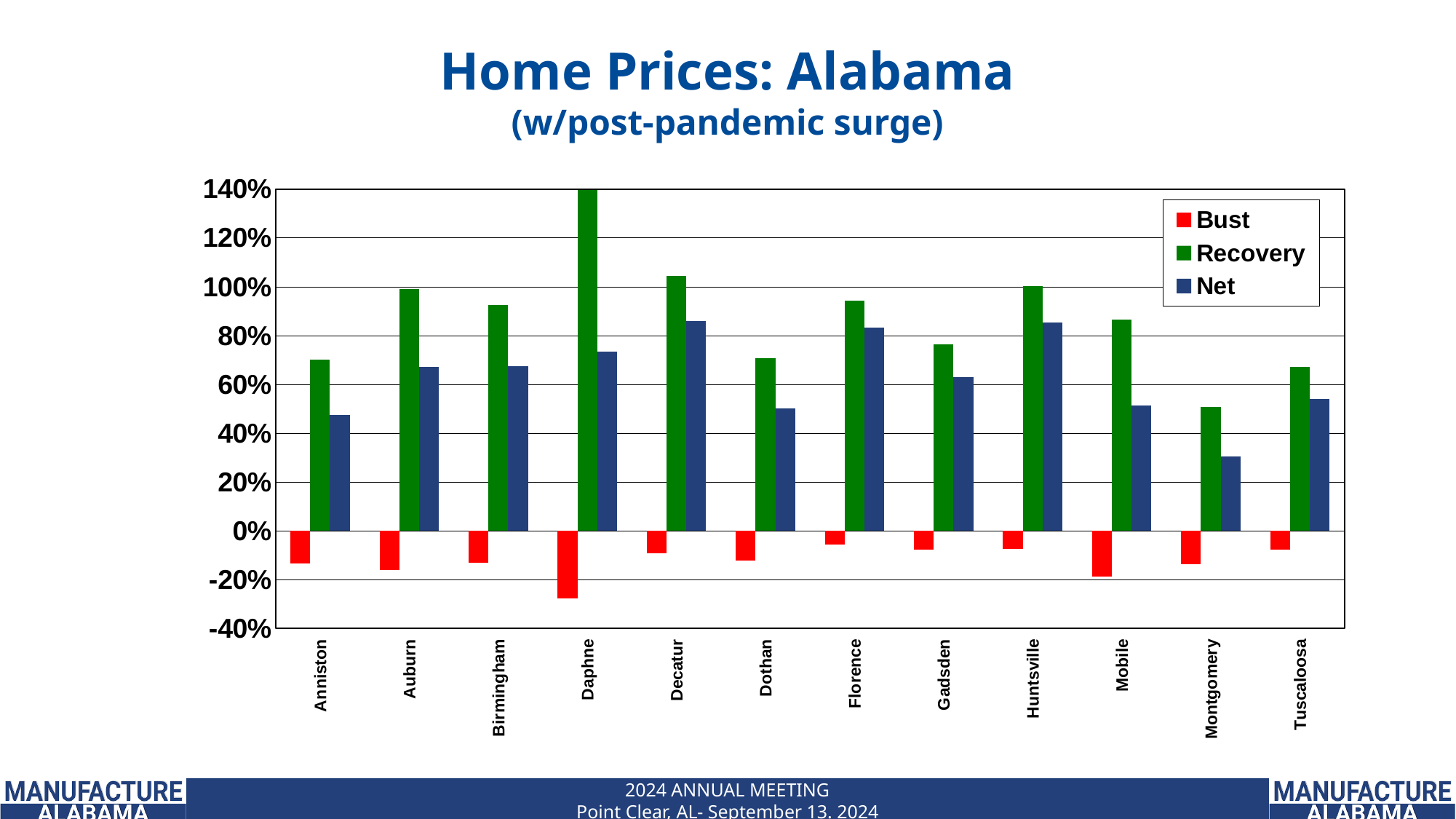
Which city has the lowest (most negative) Bust value? Daphne Which city has the lowest Net value? Montgomery How many series does the legend list? 3 Which city has the highest Recovery value? Daphne Is the Net value for Montgomery greater or less than 40%? less Which city has the lowest Recovery value? Montgomery Which is larger, the Net value for Gadsden or the Net value for Dothan? Gadsden Which colour represents the Recovery series in the legend? green How many cities are shown on the x axis? 12 Is the Recovery value for Daphne greater or less than 120%? greater What kind of chart is shown on the slide? bar chart Is the Recovery value for Auburn greater or less than 80%? greater